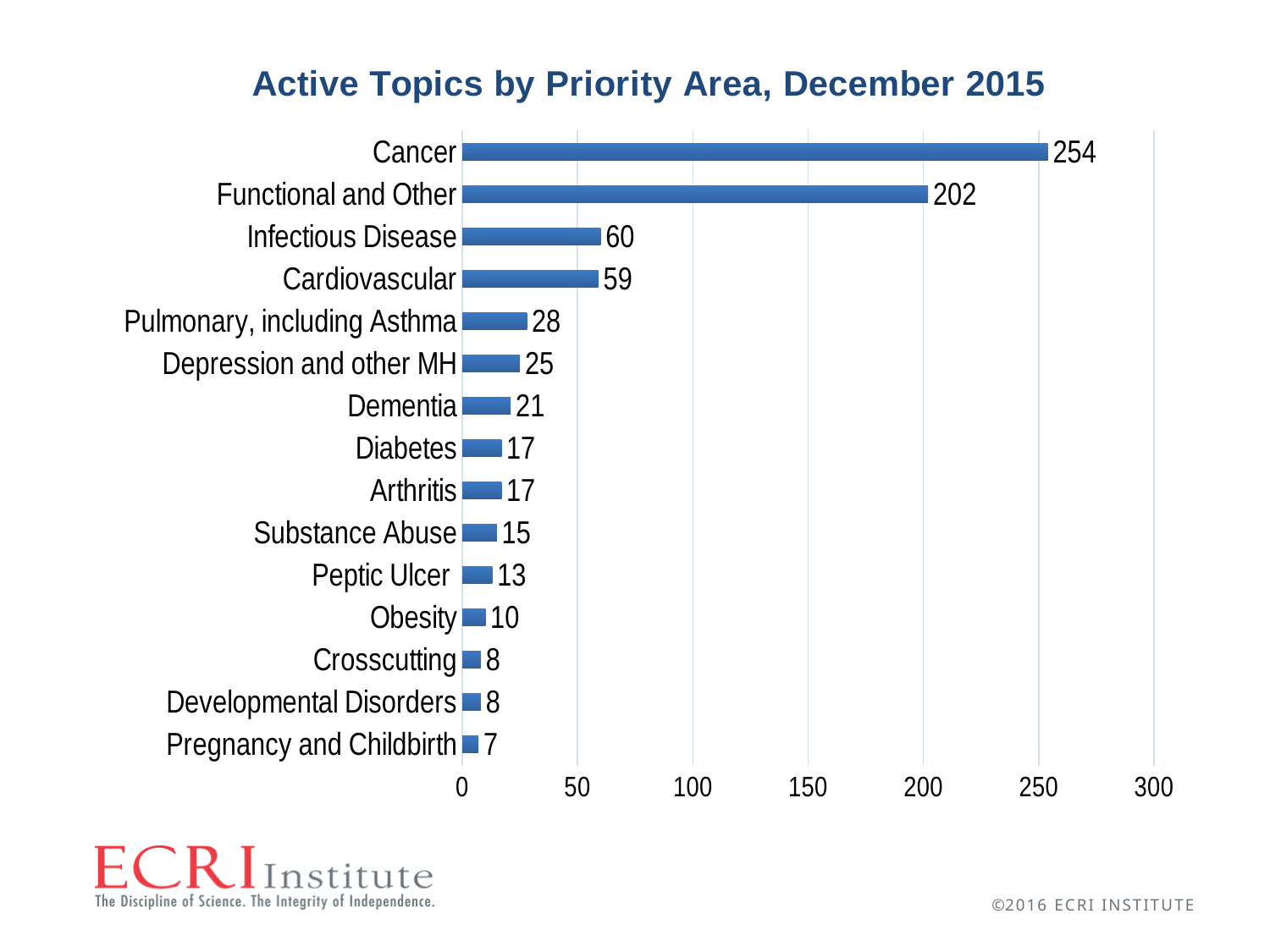
What is the difference between the values for Infectious Disease and Cardiovascular? 1 Is the value for Functional and Other greater or less than 200? greater What is the difference between the values for Cancer and Functional and Other? 52 What is the value for Dementia? 21 Which is larger, the value for Pulmonary, including Asthma or the value for Depression and other MH? Pulmonary, including Asthma How many priority areas are shown in the chart? 15 Which priority area has the highest number of active topics? Cancer What is the title of the chart? Active Topics by Priority Area, December 2015 Which priority area has the lowest number of active topics? Pregnancy and Childbirth What kind of chart is shown on the slide? Bar chart What is the value for Cancer? 254 What is the value for Functional and Other? 202